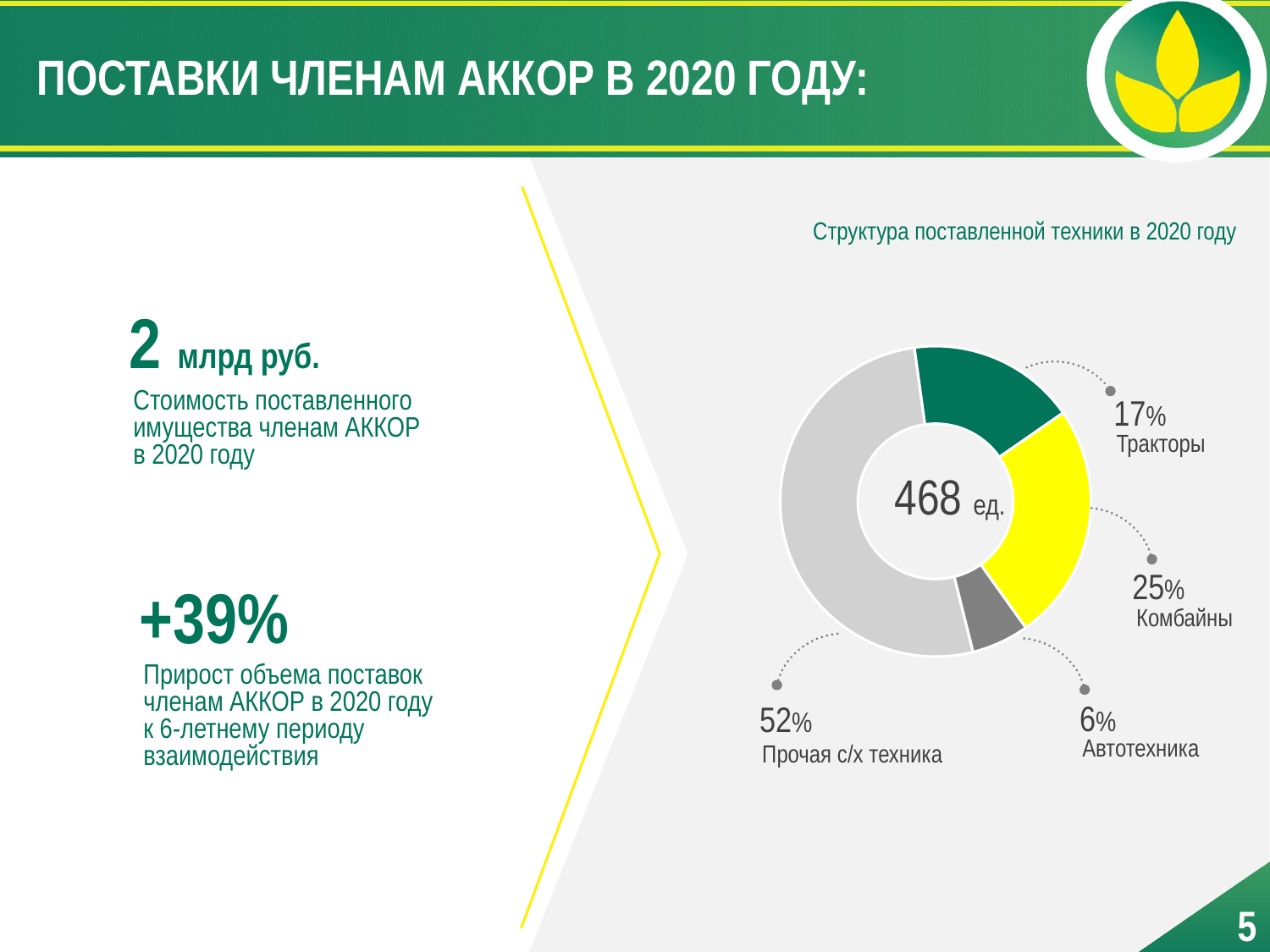
What share of the chart is Комбайны? 25% Which category has the smallest share in the chart? Автотехника What share of the chart is Тракторы? 17% What share of the chart is Прочая с/х техника? 52% What share of the chart is Автотехника? 6% What total number of units is shown in the centre of the chart? 468 ед. How many categories are shown in the chart? 4 What is the title of the chart? Структура поставленной техники в 2020 году Which is larger, the share for Тракторы or the share for Автотехника? Тракторы Which category has the largest share in the chart? Прочая с/х техника What is the difference in percentage points between Комбайны and Тракторы? 8 What kind of chart is shown on the slide? Donut (pie) chart